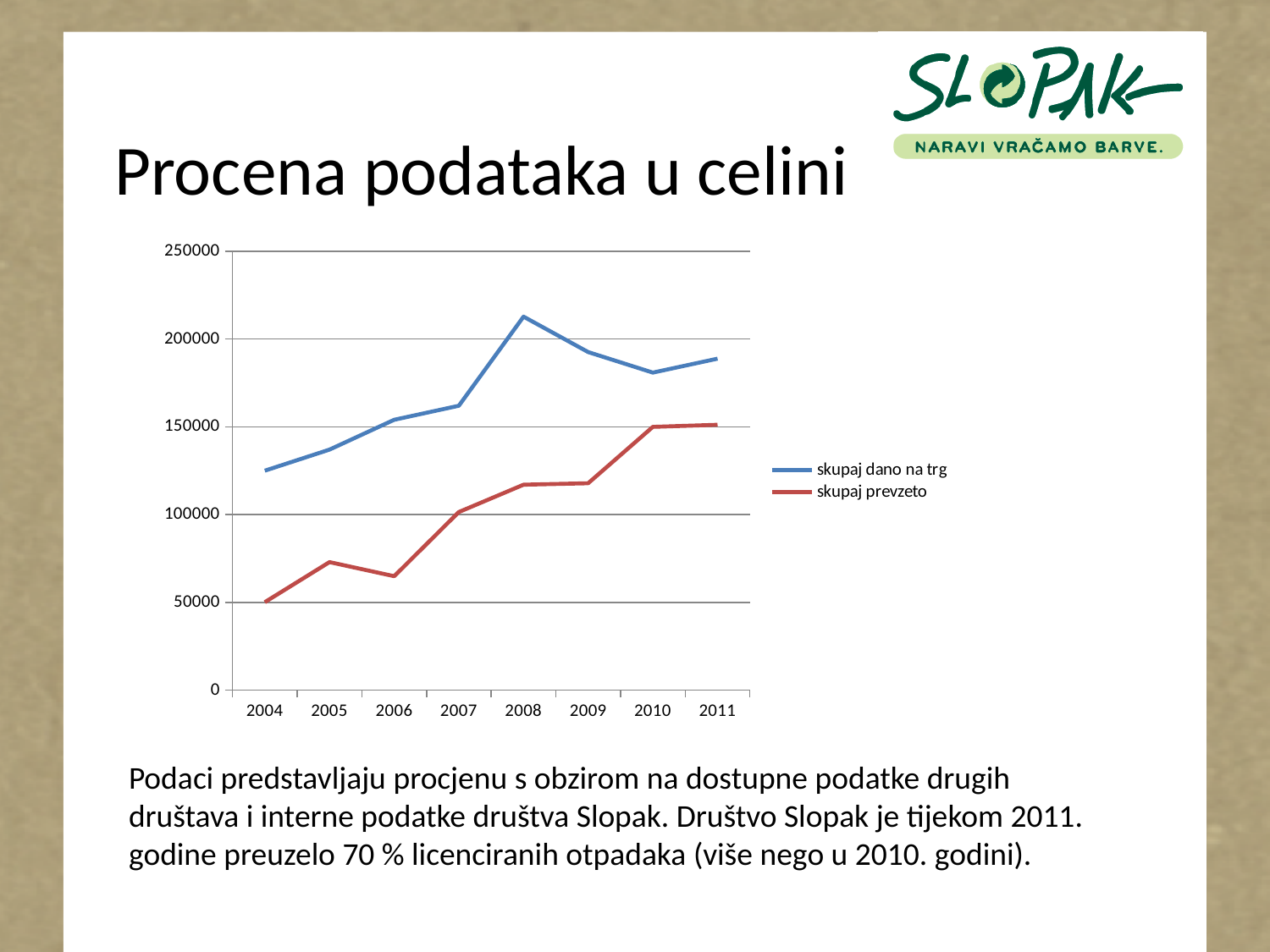
Which colour is used for the 'skupaj prevzeto' series? red Is the value for 'skupaj dano na trg' in 2004 greater or less than 100000? greater What kind of chart is shown on the slide? line chart Which series has the higher value in 2011, 'skupaj dano na trg' or 'skupaj prevzeto'? skupaj dano na trg What is the title of the slide containing the chart? Procena podataka u celini How many series does the legend list? 2 In which year is the 'skupaj prevzeto' series at its lowest? 2004 In which year does the 'skupaj dano na trg' series reach its highest value? 2008 Is the value for 'skupaj prevzeto' in 2006 greater or less than 100000? less Is the value for 'skupaj dano na trg' in 2008 greater or less than 200000? greater Does the 'skupaj prevzeto' series generally rise or fall from 2004 to 2011? rise How many years are shown on the x axis? 8